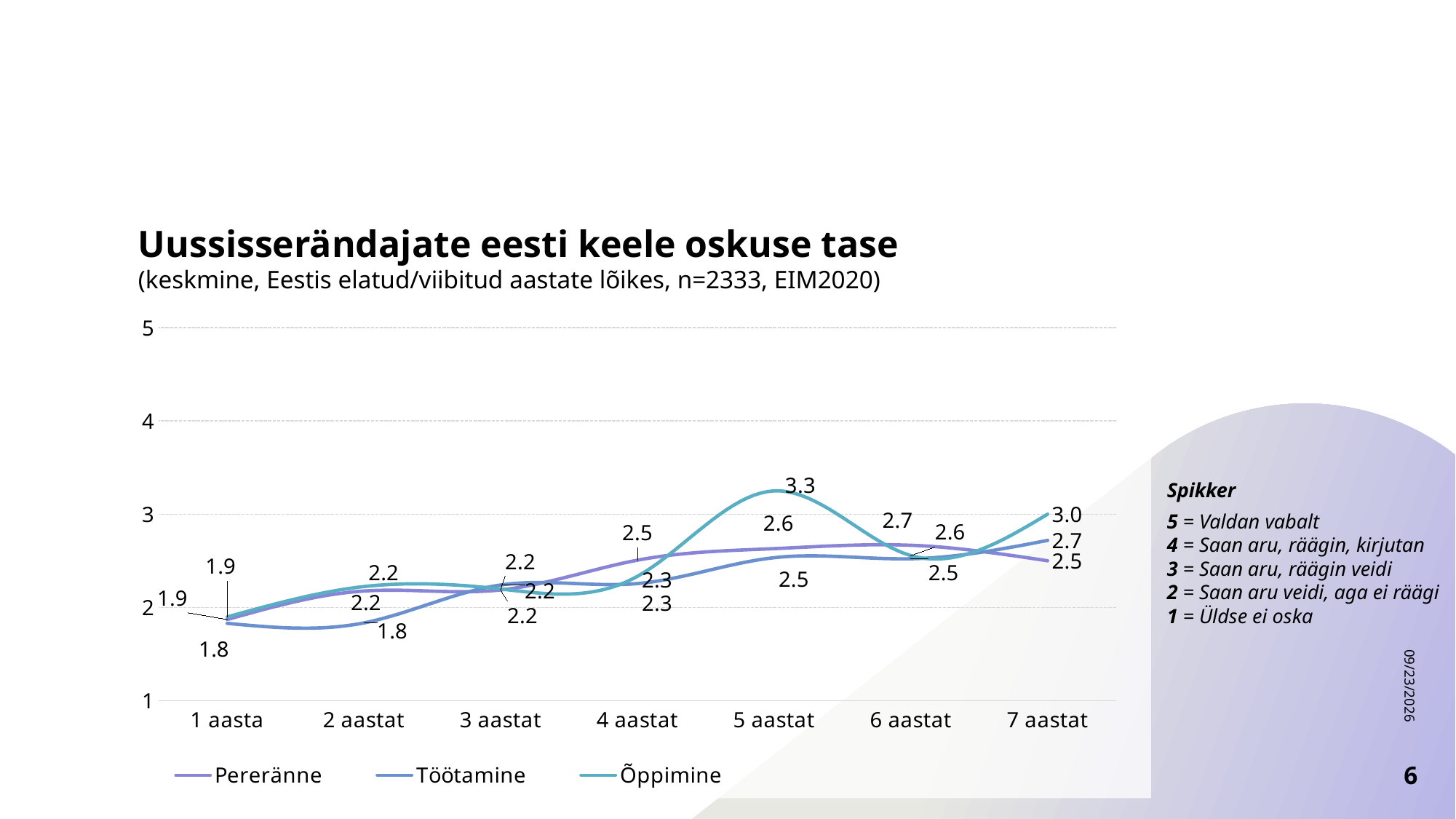
How many series does the legend list? 3 What is the value for Pererände at 7 aastat? 2.5 What kind of chart is shown on the slide? line chart What is the value for Töötamine at 1 aasta? 1.8 What is the value for Õppimine at 5 aastat? 3.3 What is the value for Pererände at 4 aastat? 2.5 Which series has the highest value at 5 aastat? Õppimine At 7 aastat, which is larger: Õppimine or Töötamine? Õppimine What is the difference between Õppimine and Töötamine at 5 aastat? 0.8 How many categories are shown on the x axis? 7 What is the title of the chart? Uussisserändajate eesti keele oskuse tase Does the Pererände series rise or fall from 1 aasta to 6 aastat? rise